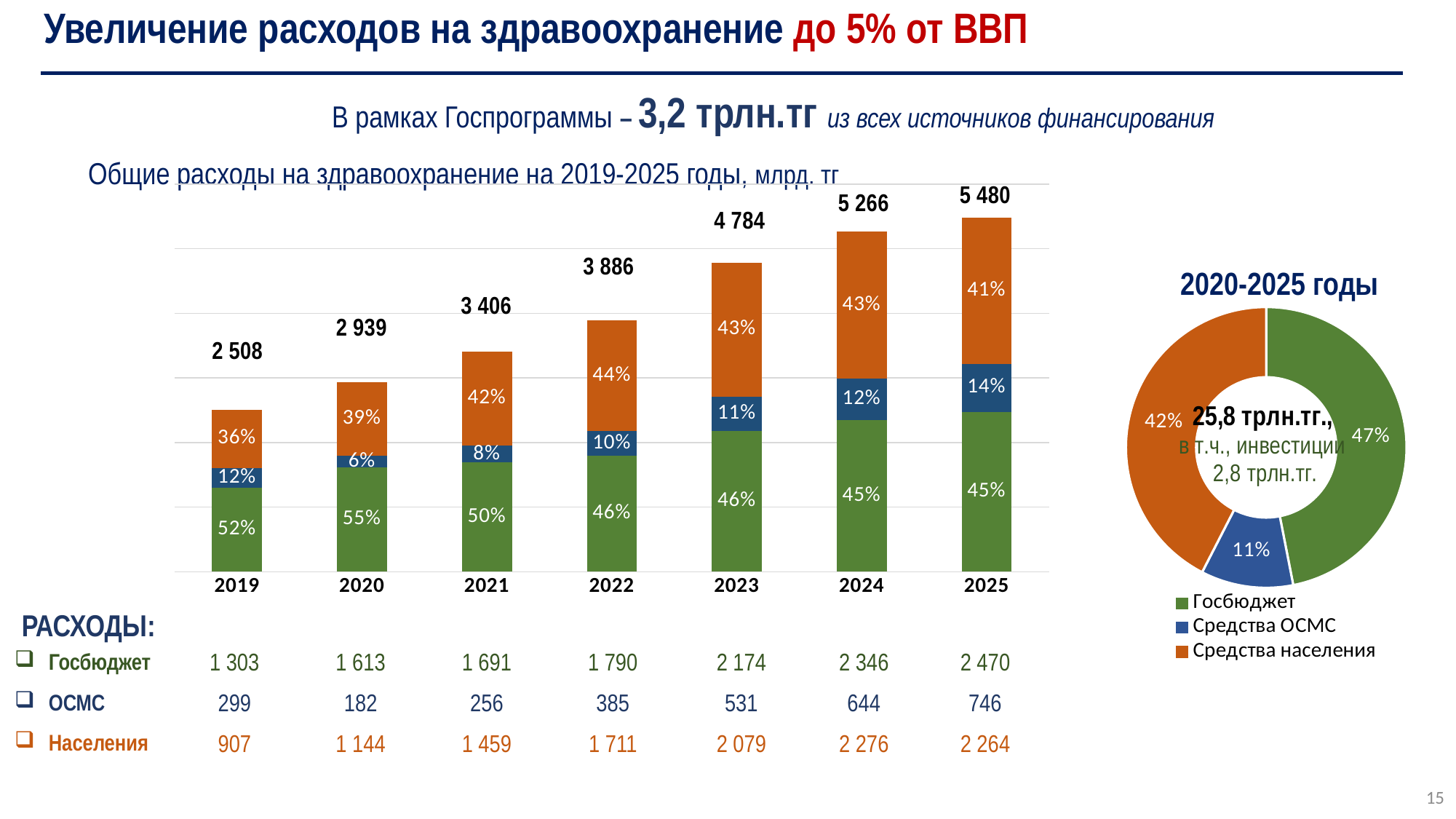
In the bar chart "Общие расходы на здравоохранение на 2019-2025 годы", which year has the lowest total? 2019 In the bar chart "Общие расходы на здравоохранение на 2019-2025 годы", what is the total value shown above the bar for 2023? 4 784 In the bar chart "Общие расходы на здравоохранение на 2019-2025 годы", do the total values rise or fall from 2019 to 2025? Rise How many years (bars) are shown in the bar chart "Общие расходы на здравоохранение на 2019-2025 годы"? 7 In the doughnut chart "2020-2025 годы", which category has the largest share? Госбюджет In the bar chart "Общие расходы на здравоохранение на 2019-2025 годы", what percentage does the blue (ОСМС) segment show for 2025? 14% In the bar chart "Общие расходы на здравоохранение на 2019-2025 годы", what percentage does the green (Госбюджет) segment show for 2020? 55% In the bar chart "Общие расходы на здравоохранение на 2019-2025 годы", what is the difference between the totals for 2025 and 2024? 214 What kind of chart is the chart titled "2020-2025 годы" on the right of the slide? Doughnut (pie) chart In the doughnut chart "2020-2025 годы", what share is shown for Средства ОСМС? 11% What kind of chart is the chart titled "Общие расходы на здравоохранение на 2019-2025 годы, млрд. тг"? Stacked bar chart In the bar chart "Общие расходы на здравоохранение на 2019-2025 годы", which year has the highest total? 2025